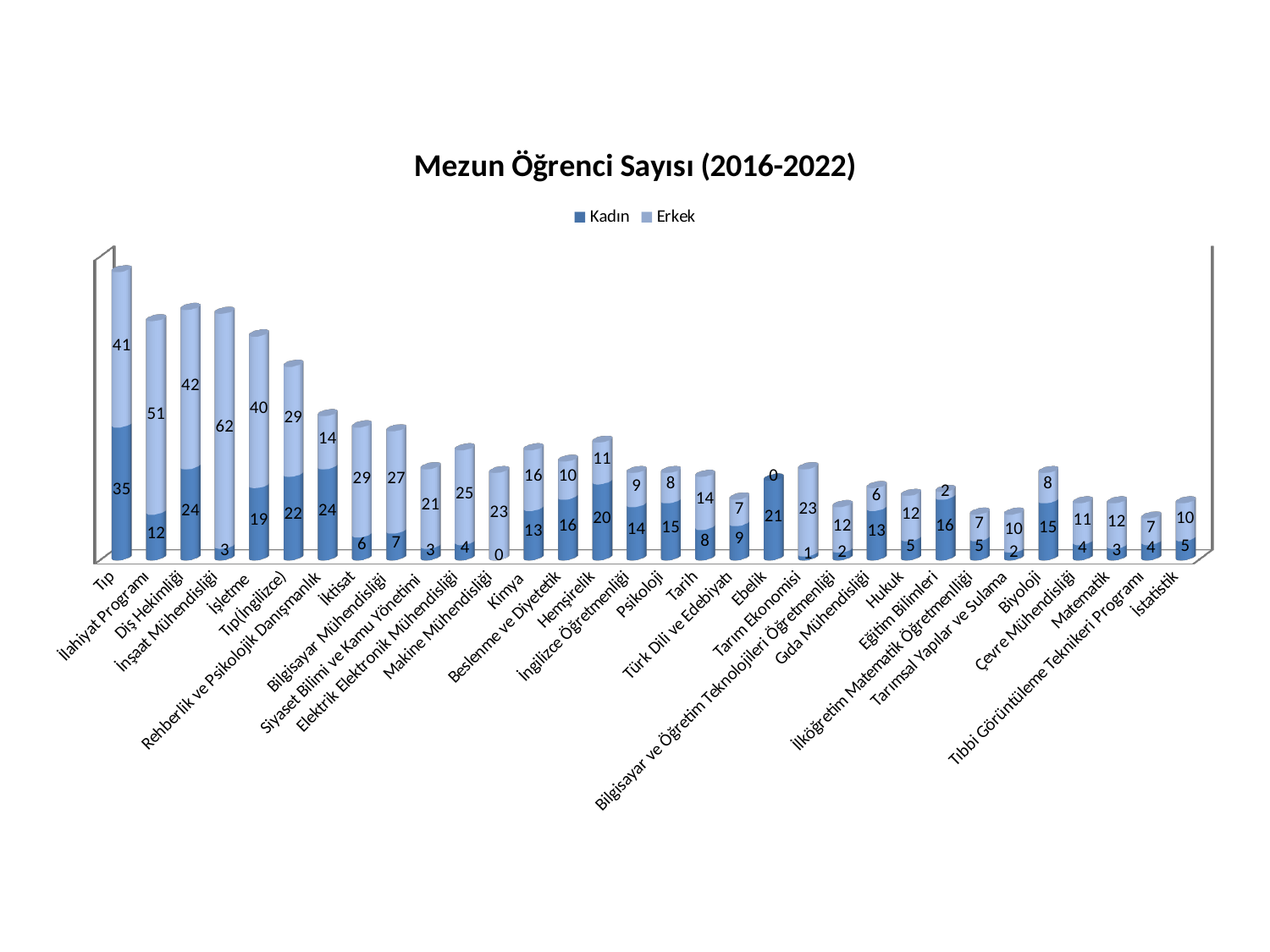
What is the Kadın value for Ebelik? 21 What is the total of the stacked bar for Tıp? 76 Which category has the highest Erkek value? İnşaat Mühendisliği How many series does the legend list? 2 What is the Erkek value for İnşaat Mühendisliği? 62 What is the difference between the Erkek and Kadın values for İlahiyat Programı? 39 What is the total of the stacked bar for Diş Hekimliği? 66 What is the Kadın value for Tıp? 35 What type of chart is shown on the slide? stacked bar chart What is the title of the chart? Mezun Öğrenci Sayısı (2016-2022) Which category has the highest Kadın value? Tıp Which is larger for Hemşirelik, the Kadın value or the Erkek value? Kadın